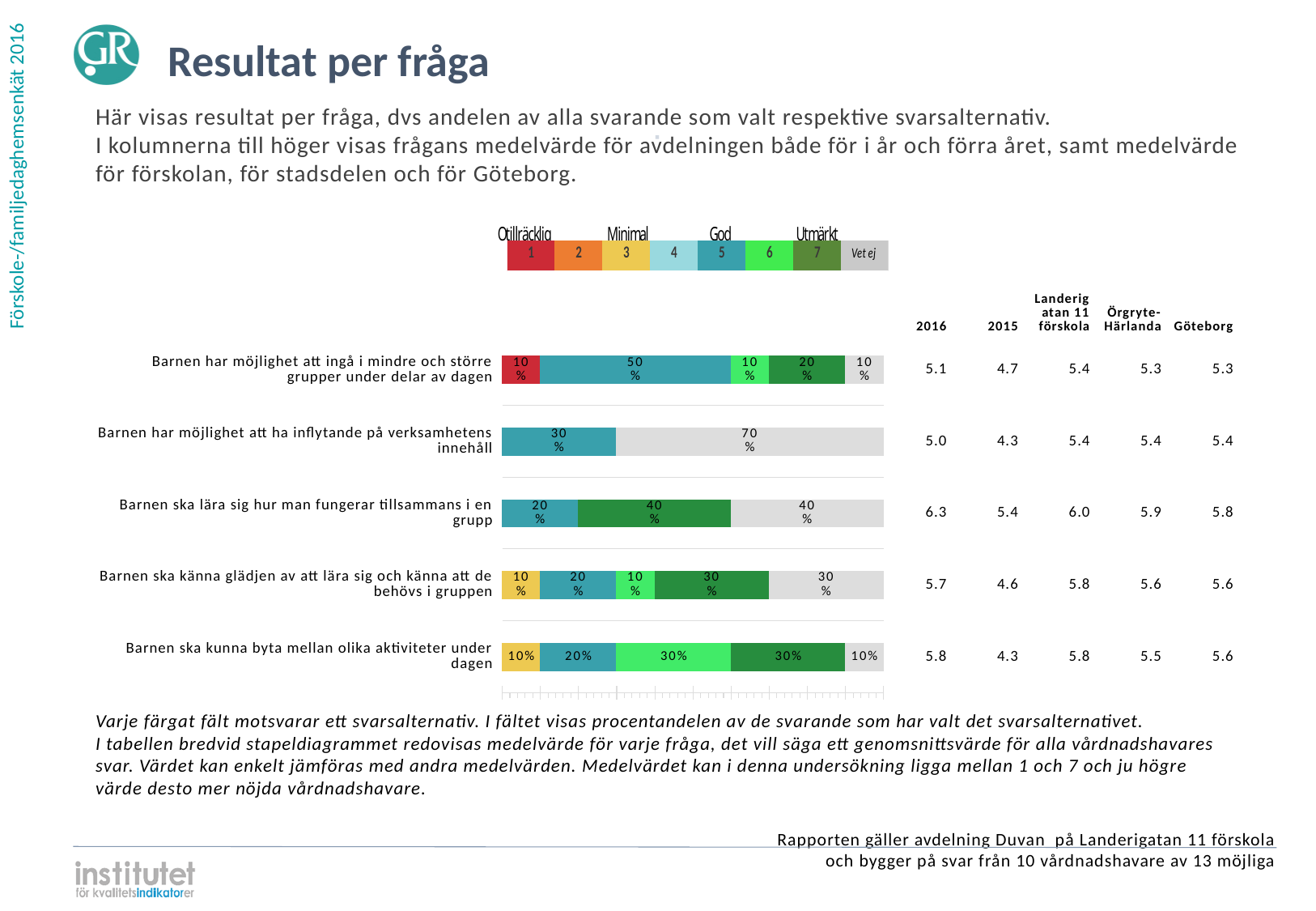
What percentage of respondents chose answer 5 (teal) for 'Barnen har möjlighet att ingå i mindre och större grupper under delar av dagen'? 50% What is the difference between the 2016 and 2015 mean values for 'Barnen ska kunna byta mellan olika aktiviteter under dagen'? 1.5 For 'Barnen ska känna glädjen av att lära sig och känna att de behövs i gruppen', which is larger: the share for answer 7 or the share for answer 5? Answer 7 (30%) What percentage of respondents chose answer 7 (dark green) for 'Barnen ska lära sig hur man fungerar tillsammans i en grupp'? 40% Which question has the largest 'Vet ej' share? Barnen har möjlighet att ha inflytande på verksamhetens innehåll Which question has a red (answer 1) segment in its bar? Barnen har möjlighet att ingå i mindre och större grupper under delar av dagen How many questions (categories) are plotted in the bar chart? 5 What is the 2016 mean value for 'Barnen ska lära sig hur man fungerar tillsammans i en grupp'? 6.3 What percentage of respondents chose 'Vet ej' for 'Barnen har möjlighet att ha inflytande på verksamhetens innehåll'? 70% What kind of chart is shown on the slide? Stacked bar chart What is the Göteborg mean value for 'Barnen har möjlighet att ha inflytande på verksamhetens innehåll'? 5.4 How many answer alternatives does the legend list, including 'Vet ej'? 8